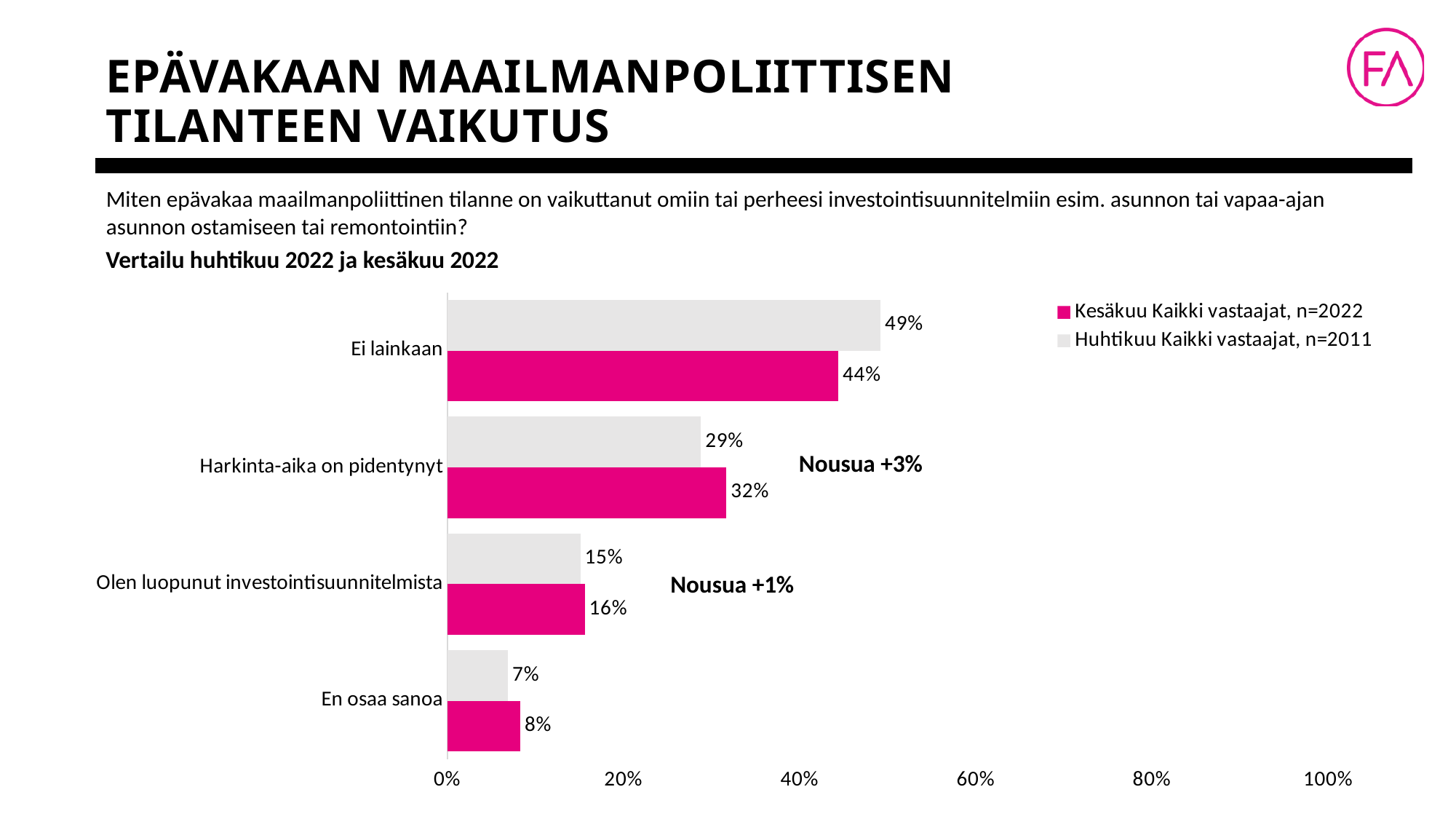
Which category has the lowest value in the Kesäkuu Kaikki vastaajat, n=2022 series? En osaa sanoa For "Harkinta-aika on pidentynyt", which series has the larger value, Kesäkuu or Huhtikuu? Kesäkuu Kaikki vastaajat, n=2022 What is the value for "Ei lainkaan" in the Kesäkuu Kaikki vastaajat, n=2022 series? 44% What is the difference between the Huhtikuu and Kesäkuu values for "Ei lainkaan"? 5% What kind of chart is shown on the slide? Bar chart What colour are the bars for the Kesäkuu Kaikki vastaajat, n=2022 series? Pink (magenta) What is the value for "Harkinta-aika on pidentynyt" in the Huhtikuu Kaikki vastaajat, n=2011 series? 29% What is the value for "Olen luopunut investointisuunnitelmista" in the Kesäkuu Kaikki vastaajat, n=2022 series? 16% How many categories are shown on the chart? 4 How many series does the legend list? 2 What is the value for "En osaa sanoa" in the Huhtikuu Kaikki vastaajat, n=2011 series? 7% Which category has the highest value in the Huhtikuu Kaikki vastaajat, n=2011 series? Ei lainkaan